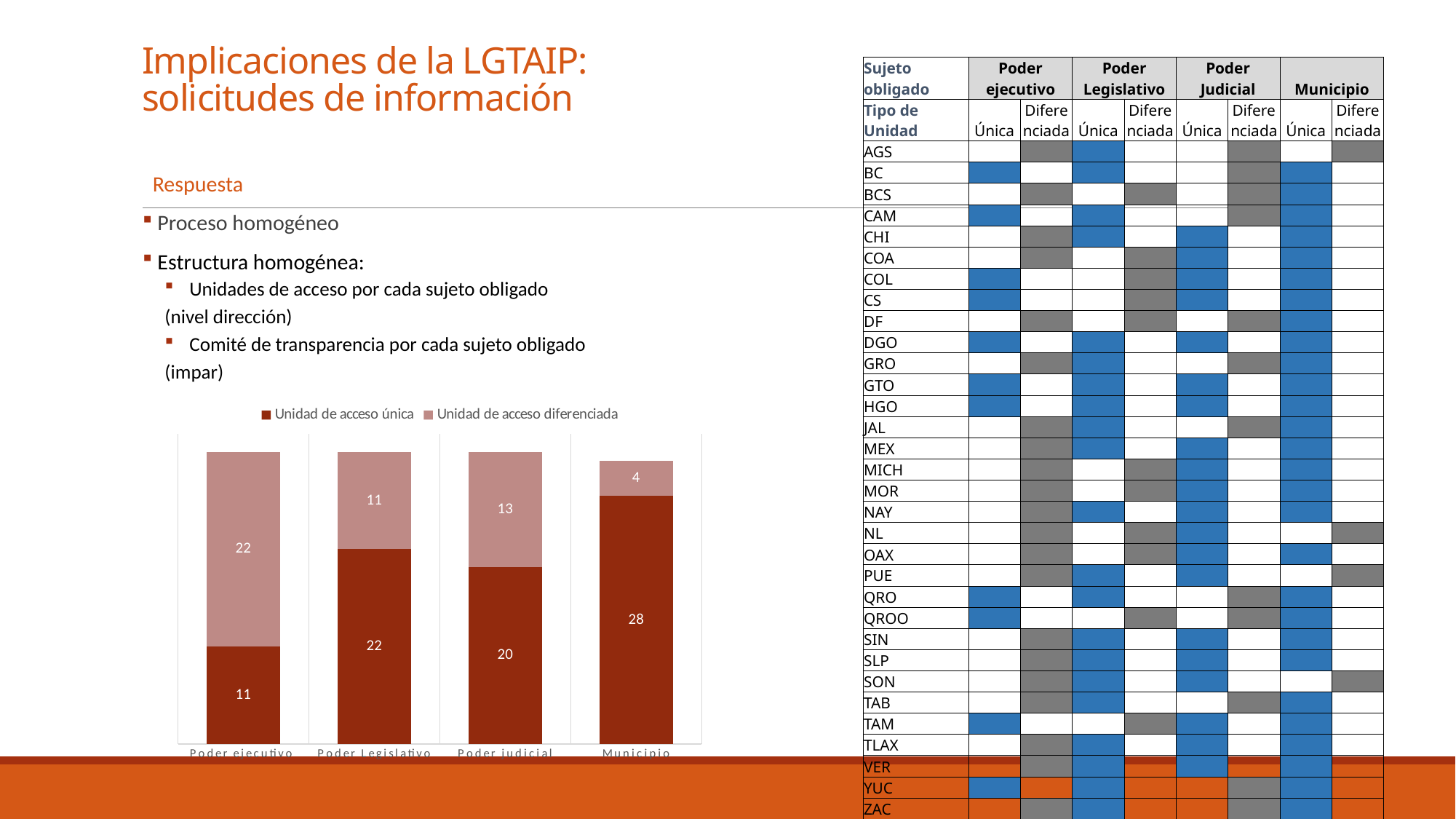
How many categories are shown on the x axis of the chart? 4 Which is larger for Poder ejecutivo: Unidad de acceso única or Unidad de acceso diferenciada? Unidad de acceso diferenciada Which category has the highest value for Unidad de acceso única? Municipio What is the value of Unidad de acceso única for Poder ejecutivo? 11 What is the value of Unidad de acceso única for Municipio? 28 How many series does the chart legend list? 2 What is the value of Unidad de acceso diferenciada for Poder ejecutivo? 22 What is the difference between Unidad de acceso única for Poder Legislativo and Poder judicial? 2 What type of chart is shown on the slide? stacked bar chart Which category has the lowest value for Unidad de acceso diferenciada? Municipio What is the value of Unidad de acceso diferenciada for Poder judicial? 13 What is the total of the stacked bar for Poder Legislativo? 33